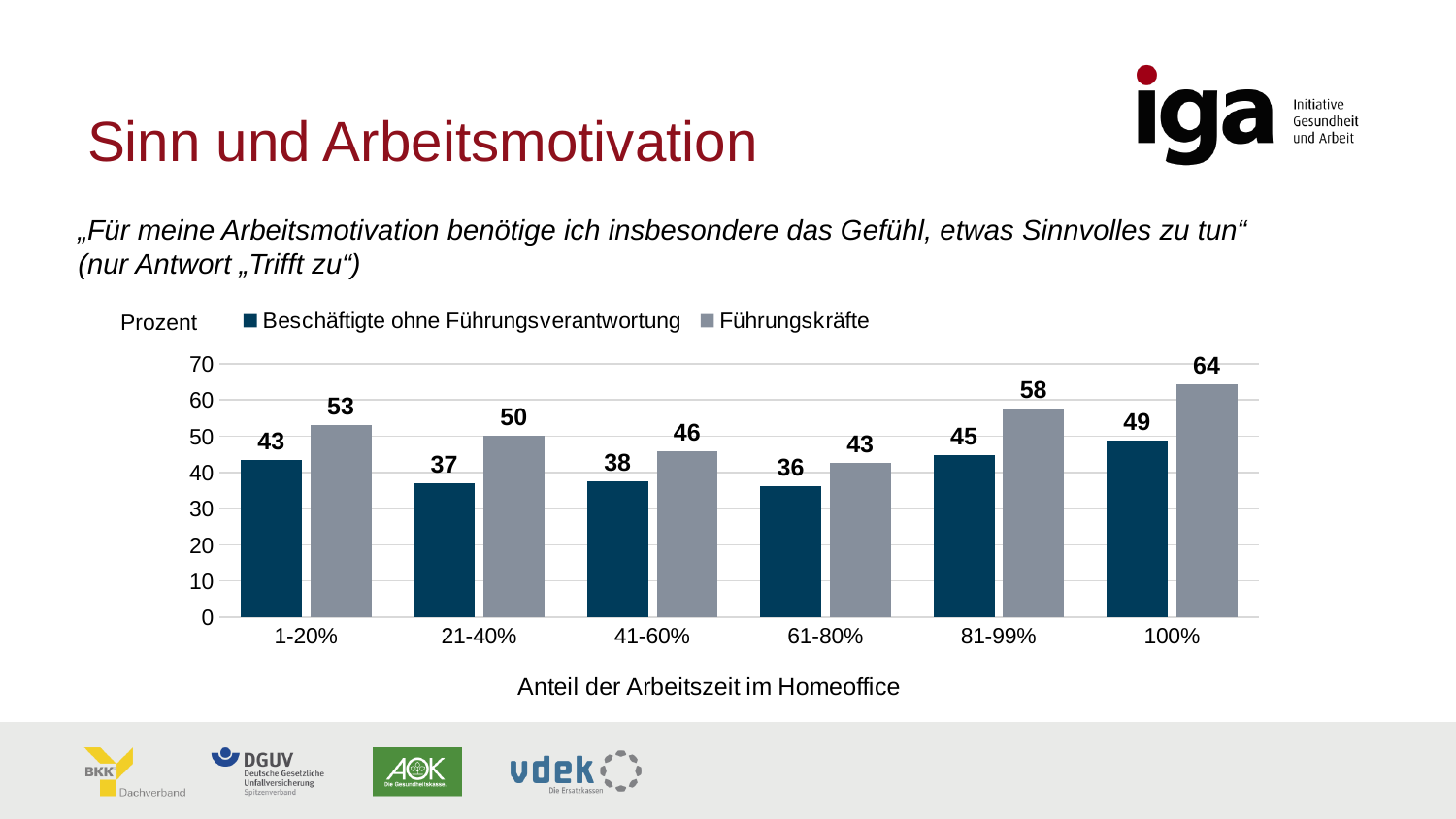
Which category has the highest value for Führungskräfte? 100% Which series is shown in dark blue? Beschäftigte ohne Führungsverantwortung How many categories are shown on the x axis? 6 What kind of chart is shown on the slide? bar chart What is the x-axis title of the chart? Anteil der Arbeitszeit im Homeoffice What is the value for Beschäftigte ohne Führungsverantwortung in the 61-80% category? 36 Which category has the lowest value for Beschäftigte ohne Führungsverantwortung? 61-80% How many series does the legend list? 2 Which is larger: Beschäftigte ohne Führungsverantwortung in the 1-20% category or in the 81-99% category? 81-99% What is the value for Führungskräfte in the 100% category? 64 What is the value for Führungskräfte in the 21-40% category? 50 What is the difference between Führungskräfte and Beschäftigte ohne Führungsverantwortung in the 100% category? 15